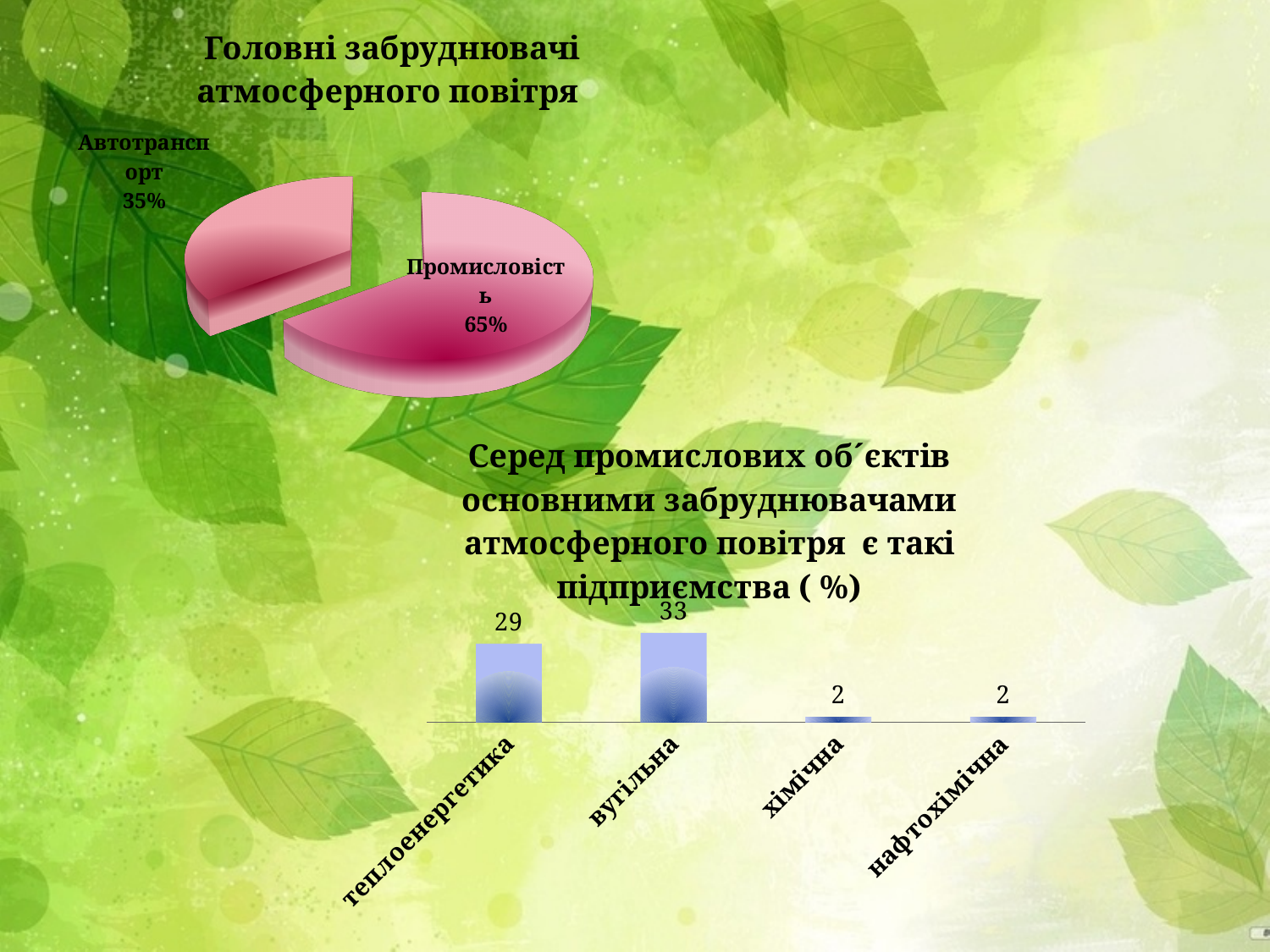
What kind of chart is the chart at the bottom of the slide? bar chart In the pie chart 'Головні забруднювачі атмосферного повітря', how many slices are there? 2 In the bar chart at the bottom of the slide, which category has the highest value? вугільна In the pie chart 'Головні забруднювачі атмосферного повітря', what share does Автотранспорт have? 35% In the bar chart at the bottom of the slide, what is the value for хімічна? 2 What kind of chart is the chart at the top of the slide titled 'Головні забруднювачі атмосферного повітря'? pie chart In the bar chart at the bottom of the slide, how many categories are shown? 4 In the pie chart 'Головні забруднювачі атмосферного повітря', which slice is the largest? Промисловість In the bar chart at the bottom of the slide, what is the value for теплоенергетика? 29 In the bar chart at the bottom of the slide, what is the value for вугільна? 33 In the bar chart at the bottom of the slide, what is the difference between the values for вугільна and теплоенергетика? 4 In the pie chart 'Головні забруднювачі атмосферного повітря', what share does Промисловість have? 65%